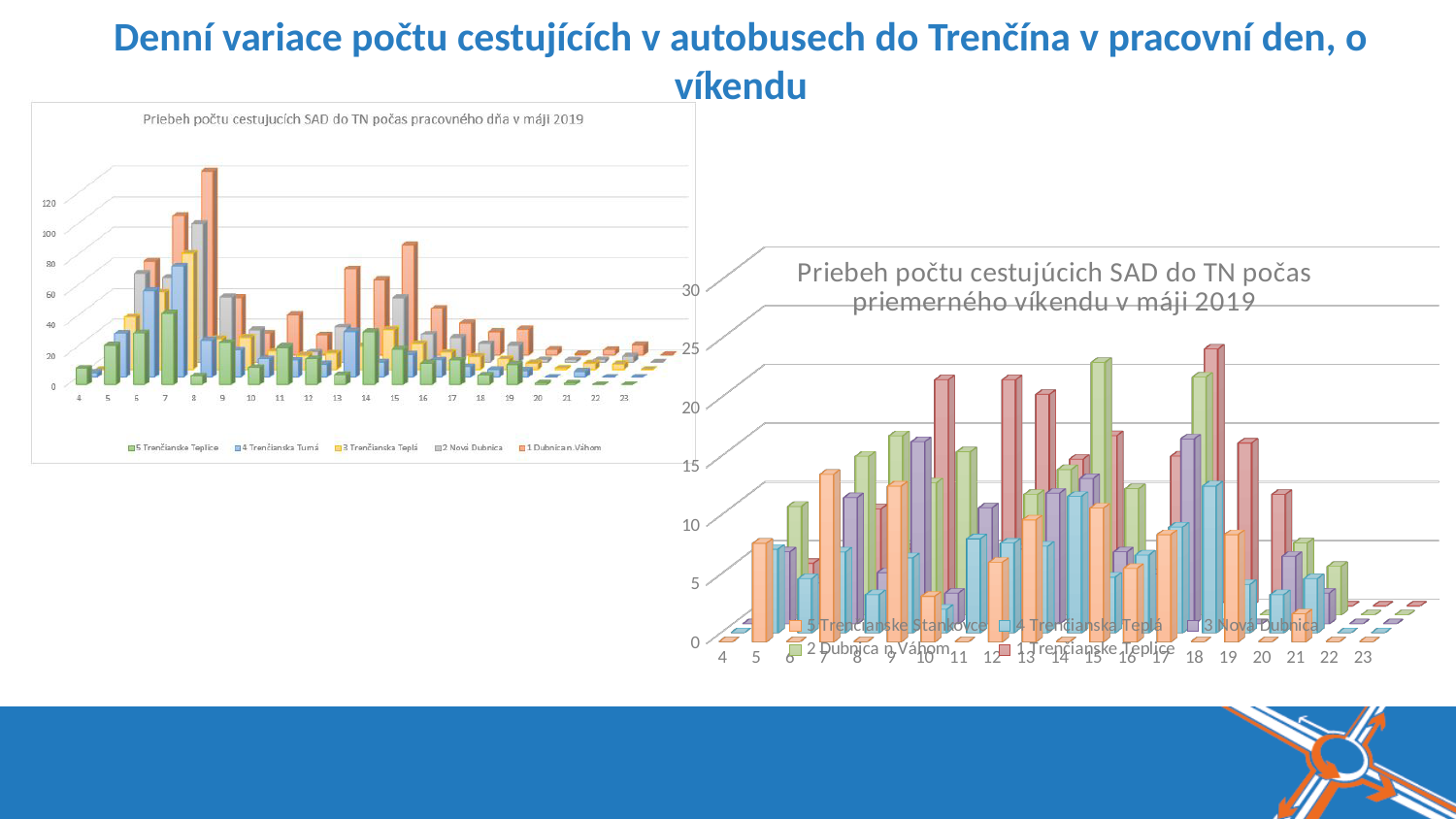
In the right chart (priemerného víkendu), is the value for 1 Trenčianske Teplice at hour 18 greater or less than 20? less How many hour categories are shown on the x axis of the right chart (priemerného víkendu)? 20 What kind of chart is the left chart, titled 'Priebeh počtu cestujúcich SAD do TN počas pracovného dňa v máji 2019'? bar chart What kind of chart is the right chart, titled 'Priebeh počtu cestujúcich SAD do TN počas priemerného víkendu v máji 2019'? bar chart How many series does the legend of the right chart (priemerného víkendu) list? 5 In the left chart (pracovného dňa), is the value for 1 Dubnica n.Váhom at hour 8 greater or less than 100? greater How many hour categories are shown on the x axis of the left chart (pracovného dňa)? 20 In the left chart (pracovného dňa), at which hour does the tallest bar of the whole chart occur? 8 How many series does the legend of the left chart (pracovného dňa) list? 5 Which series is listed first in the legend of the right chart (priemerného víkendu)? 5 Trenčianske Stankovce What is the title of the right chart on the slide? Priebeh počtu cestujúcich SAD do TN počas priemerného víkendu v máji 2019